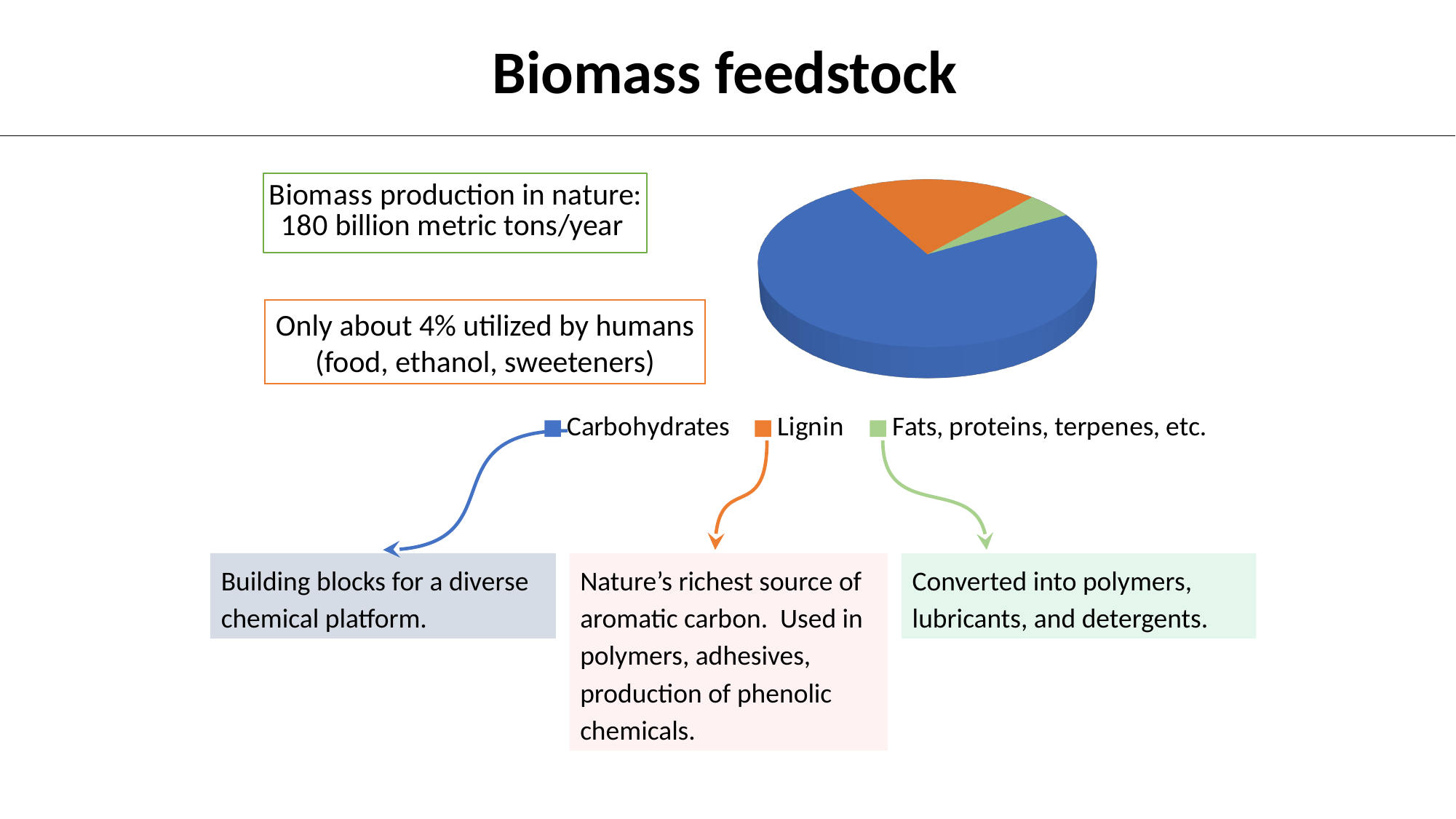
How many slices does the pie chart have? 3 What kind of chart is shown on the slide? pie chart What colour is the Lignin slice in the pie chart? orange Which category has the largest slice of the pie chart? Carbohydrates Which slice is larger in the pie chart, Lignin or Fats, proteins, terpenes, etc.? Lignin Which category has the smallest slice of the pie chart? Fats, proteins, terpenes, etc. How many entries does the pie chart's legend list? 3 Which slice is larger in the pie chart, Carbohydrates or Lignin? Carbohydrates Which category is shown in green in the pie chart? Fats, proteins, terpenes, etc.